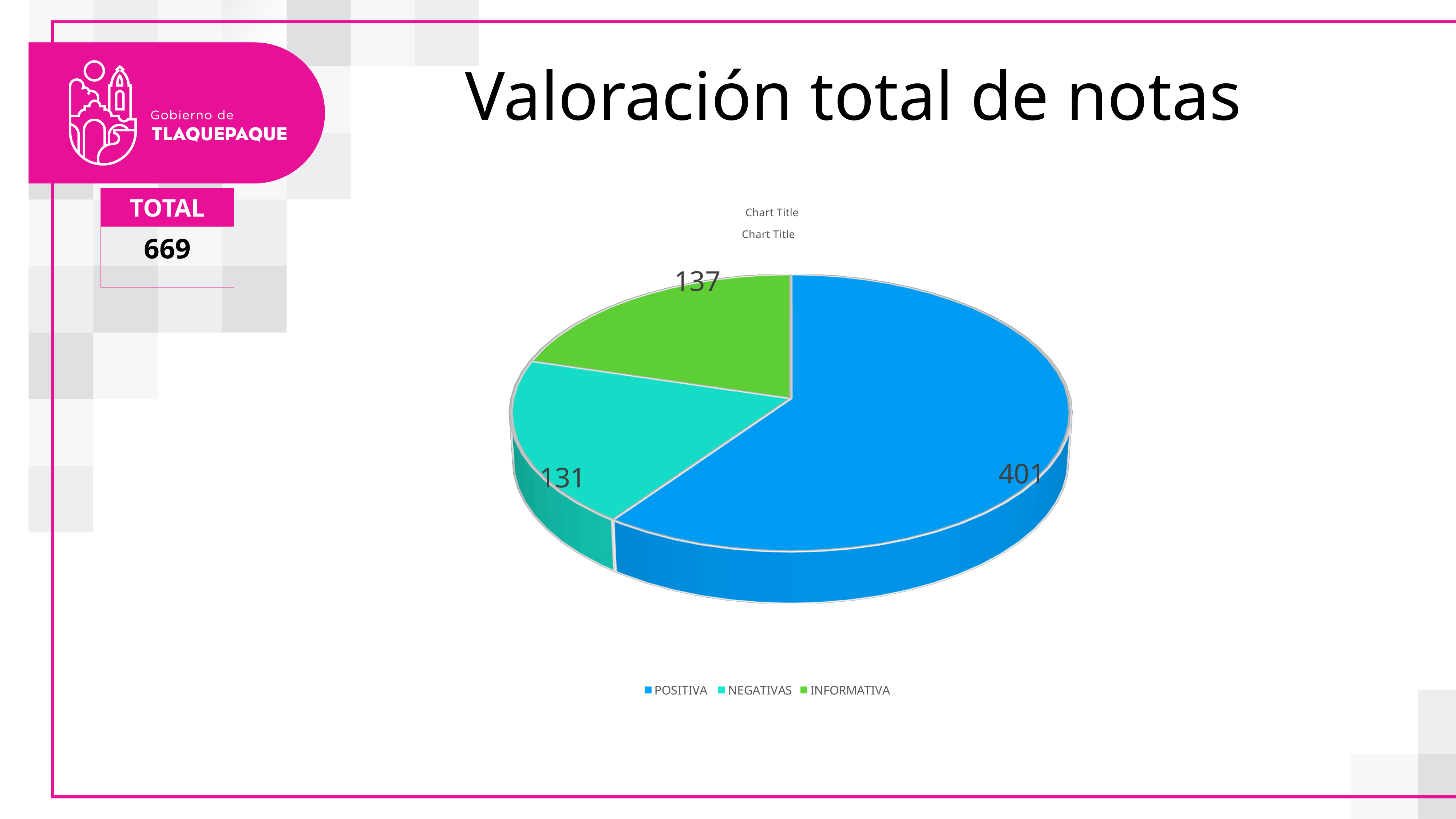
What is the value for POSITIVA in the pie chart? 401 Which category has the largest slice in the pie chart? POSITIVA What are the three legend entries of the pie chart? POSITIVA, NEGATIVAS, INFORMATIVA What type of chart is shown on the slide? pie chart Which is larger, the value for POSITIVA or the value for INFORMATIVA? POSITIVA Which category has the smallest slice in the pie chart? NEGATIVAS What is the value for INFORMATIVA in the pie chart? 137 What is the difference between the POSITIVA and NEGATIVAS values? 270 What is the difference between the INFORMATIVA and NEGATIVAS values? 6 What is the value for NEGATIVAS in the pie chart? 131 How many slices does the pie chart have? 3 What is the total of all slices in the pie chart? 669